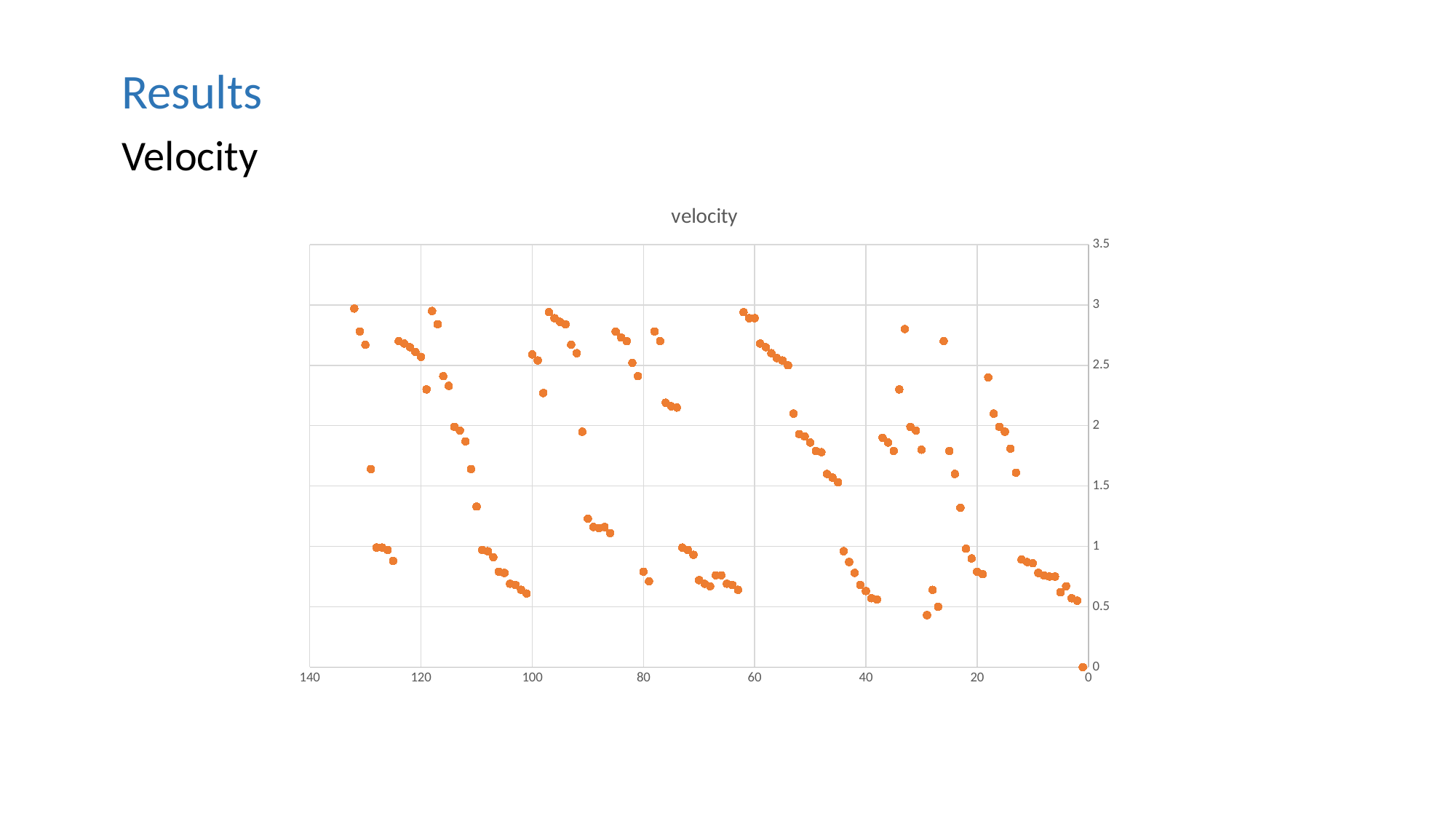
Is the lowest plotted point on the velocity chart greater or less than 0.5? less Is the point plotted at x = 0 on the velocity chart greater or less than 0.5? less Is the highest plotted point on the velocity chart greater or less than 2.5? greater What is the highest value labelled on the vertical axis of the velocity chart? 3.5 What kind of chart is shown on the slide? scatter chart What is the title of the chart? velocity